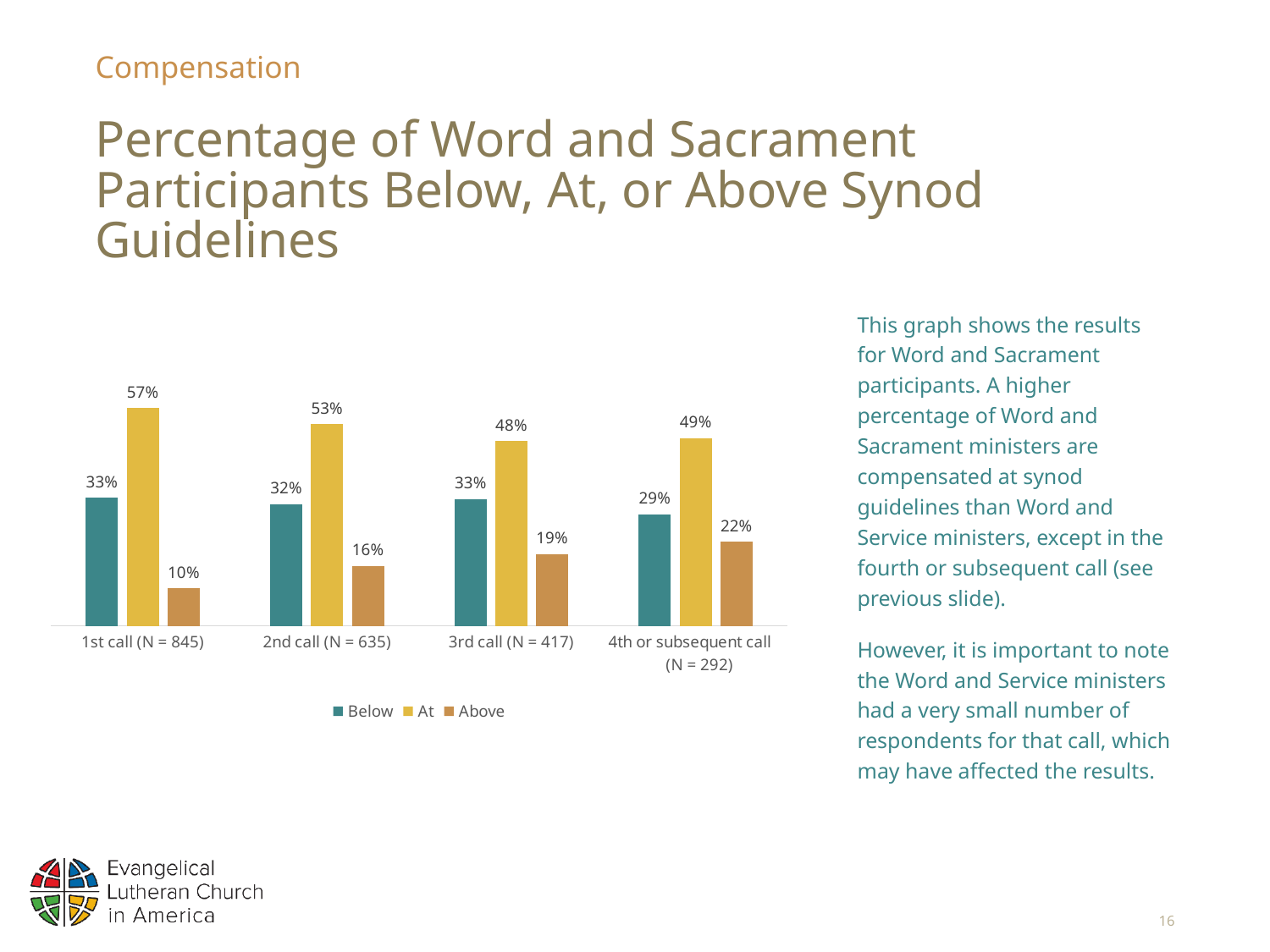
How many series does the legend list? 3 What kind of chart is shown on the slide? Bar chart How many call categories are shown on the x axis? 4 Which call category has the lowest percentage of participants compensated above synod guidelines? 1st call (N = 845) What are the three series listed in the legend? Below, At, Above What percentage of 4th or subsequent call participants are compensated above synod guidelines? 22% What is the difference between the 'At' and 'Below' percentages for 3rd call participants? 15% Which call category has the highest percentage of participants compensated at synod guidelines? 1st call (N = 845) Does the 'Above' percentage rise or fall from 1st call to 4th or subsequent call? Rise What percentage of 2nd call participants are compensated below synod guidelines? 32% Is the 'Above' percentage larger for 2nd call or 3rd call participants? 3rd call What percentage of 1st call participants are compensated at synod guidelines? 57%